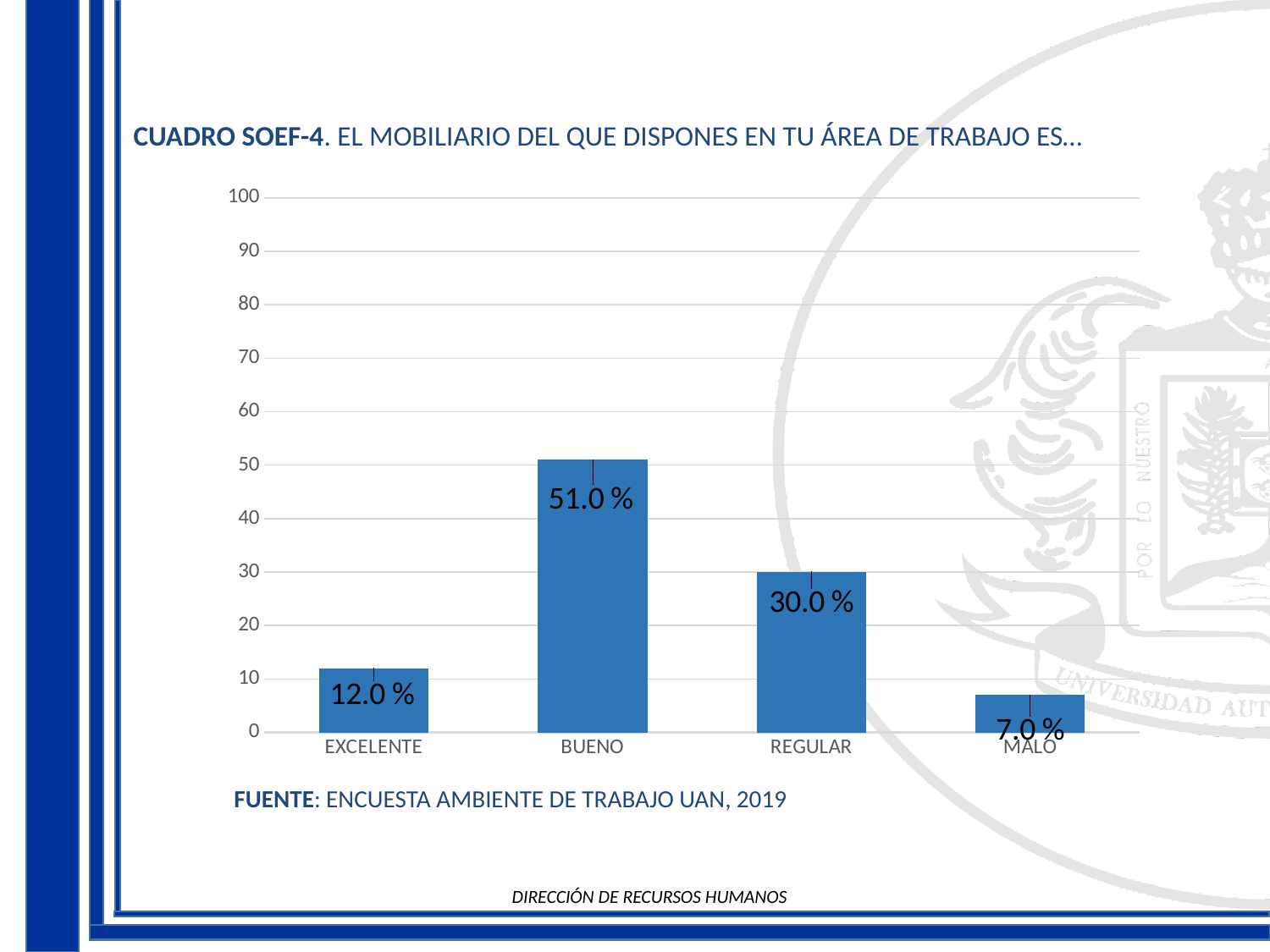
What is the value for BUENO? 51.0 % Which category has the lowest value? MALO What is the value for EXCELENTE? 12.0 % Is the value for REGULAR greater or less than 40? less What is the difference between the values for BUENO and REGULAR? 21.0 % How many categories are shown on the x axis? 4 What is the source cited below the chart? ENCUESTA AMBIENTE DE TRABAJO UAN, 2019 What kind of chart is shown on the slide? bar chart Which category has the highest value? BUENO What is the value for MALO? 7.0 % Which is larger, the value for EXCELENTE or the value for MALO? EXCELENTE What is the value for REGULAR? 30.0 %